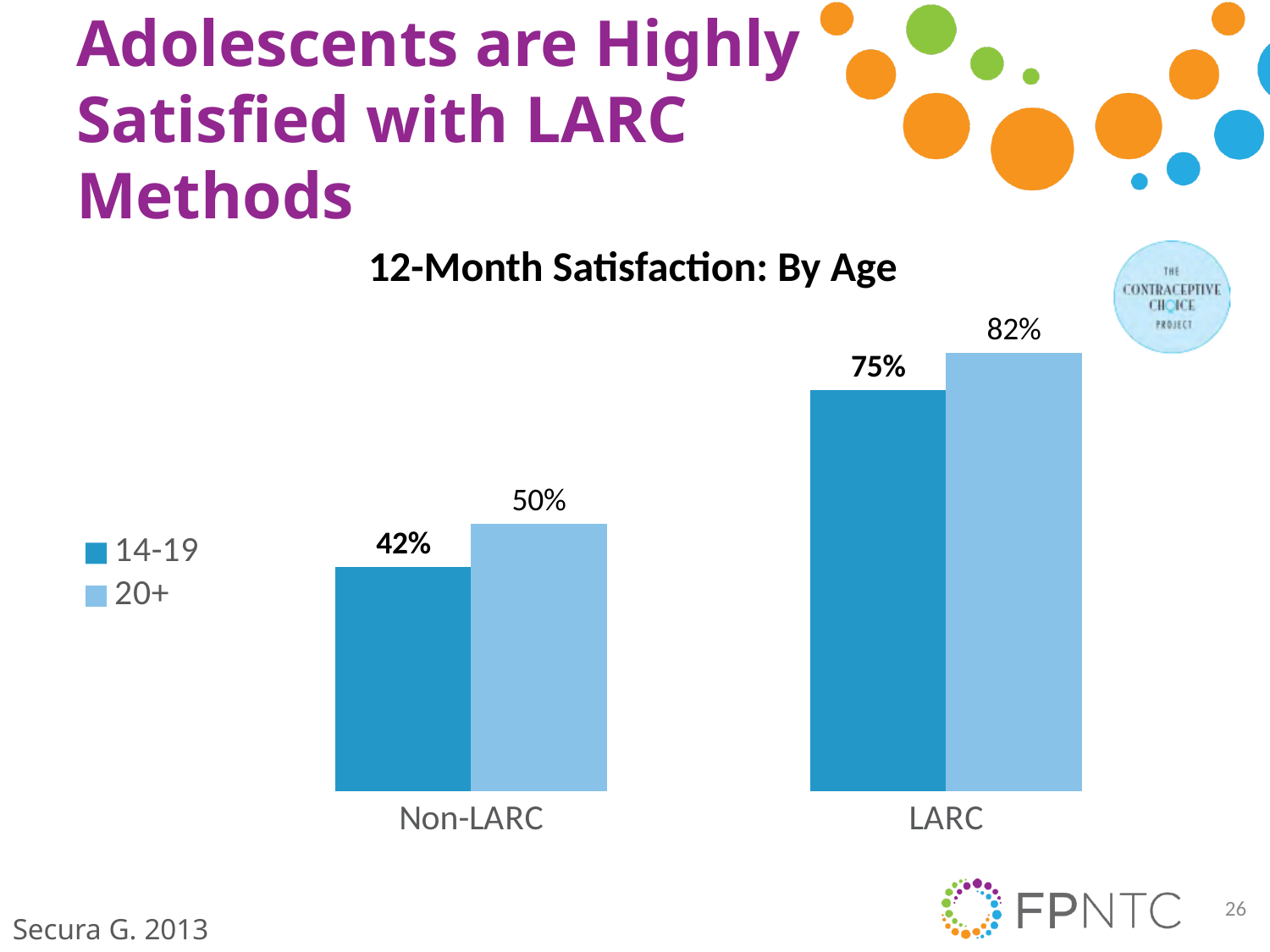
What type of chart is shown on the slide? Bar chart What is the 12-month satisfaction value for the 14-19 age group with LARC methods? 75% How many method categories are shown on the x axis of the chart? 2 What is the 12-month satisfaction value for the 14-19 age group with Non-LARC methods? 42% Which bar shows the lowest satisfaction value on the chart? 14-19 with Non-LARC (42%) How many age groups does the chart legend list? 2 Which is larger: the 14-19 satisfaction value for LARC or the 20+ satisfaction value for Non-LARC? 14-19 for LARC What is the difference between the 20+ and 14-19 satisfaction values for LARC methods? 7% What is the 12-month satisfaction value for the 20+ age group with LARC methods? 82% Which bar shows the highest satisfaction value on the chart? 20+ with LARC (82%) What is the 12-month satisfaction value for the 20+ age group with Non-LARC methods? 50% What is the difference between the 14-19 satisfaction values for LARC and Non-LARC methods? 33%